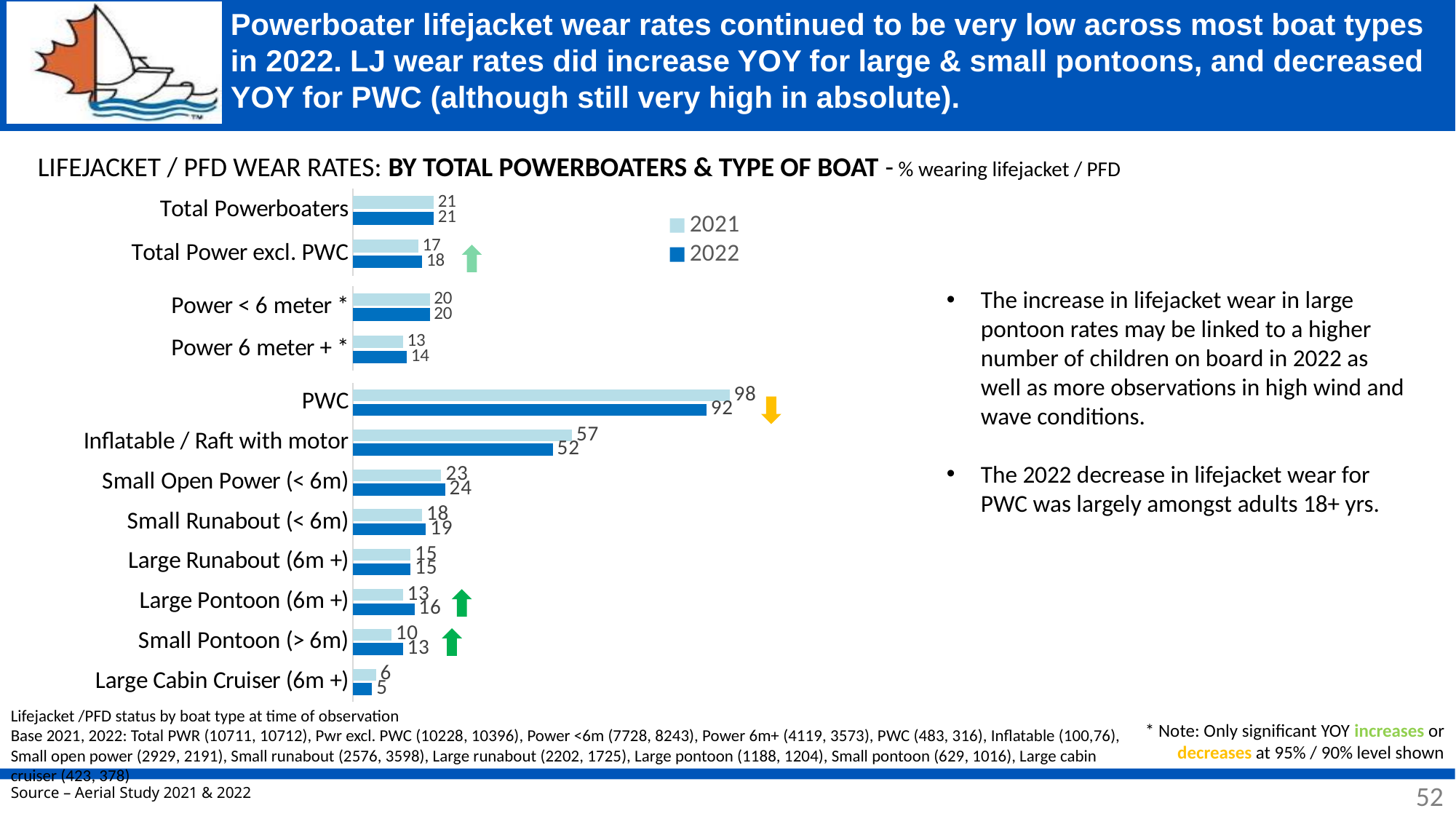
How many boat categories are plotted on the chart? 12 What is the difference between the 2021 and 2022 values for Small Pontoon (> 6m)? 3 By how much did the PWC wear rate change from 2021 to 2022? 6 Which boat type has the highest lifejacket wear rate in 2022? PWC Which boat type has the lowest lifejacket wear rate in 2021? Large Cabin Cruiser (6m +) What kind of chart is shown on the slide? Bar chart How many series does the legend list? 2 What is the 2021 lifejacket wear rate for Inflatable / Raft with motor? 57 What is the 2022 lifejacket wear rate for PWC? 92 Which colour represents 2022 in the chart? Dark blue Which is larger for Inflatable / Raft with motor: the 2021 value or the 2022 value? 2021 What is the 2022 value for Large Pontoon (6m +)? 16